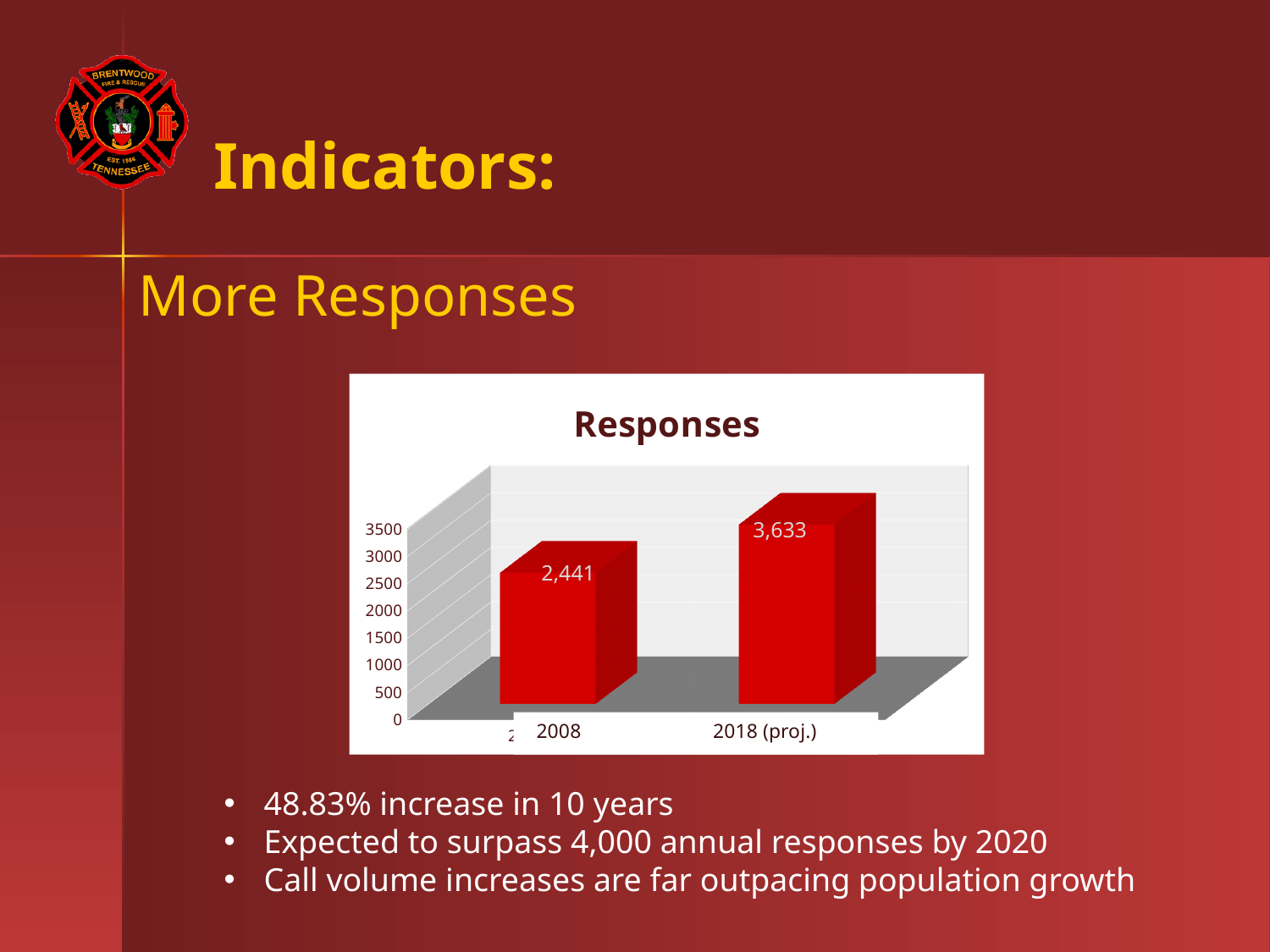
Which category has the highest value in the Responses chart? 2018 (proj.) What kind of chart is the Responses chart? bar chart What is the title of the chart on the slide? Responses Is the value for 2018 (proj.) in the Responses chart greater or less than 3500? greater How many categories are shown in the Responses chart? 2 Is the value for 2008 in the Responses chart greater or less than 3000? less Which is larger in the Responses chart, the value for 2008 or the value for 2018 (proj.)? 2018 (proj.) What is the difference between the 2018 (proj.) and 2008 values in the Responses chart? 1,192 Do the values in the Responses chart rise or fall from 2008 to 2018 (proj.)? rise What is the value for 2008 in the Responses chart? 2,441 What is the value for 2018 (proj.) in the Responses chart? 3,633 Which category has the lowest value in the Responses chart? 2008